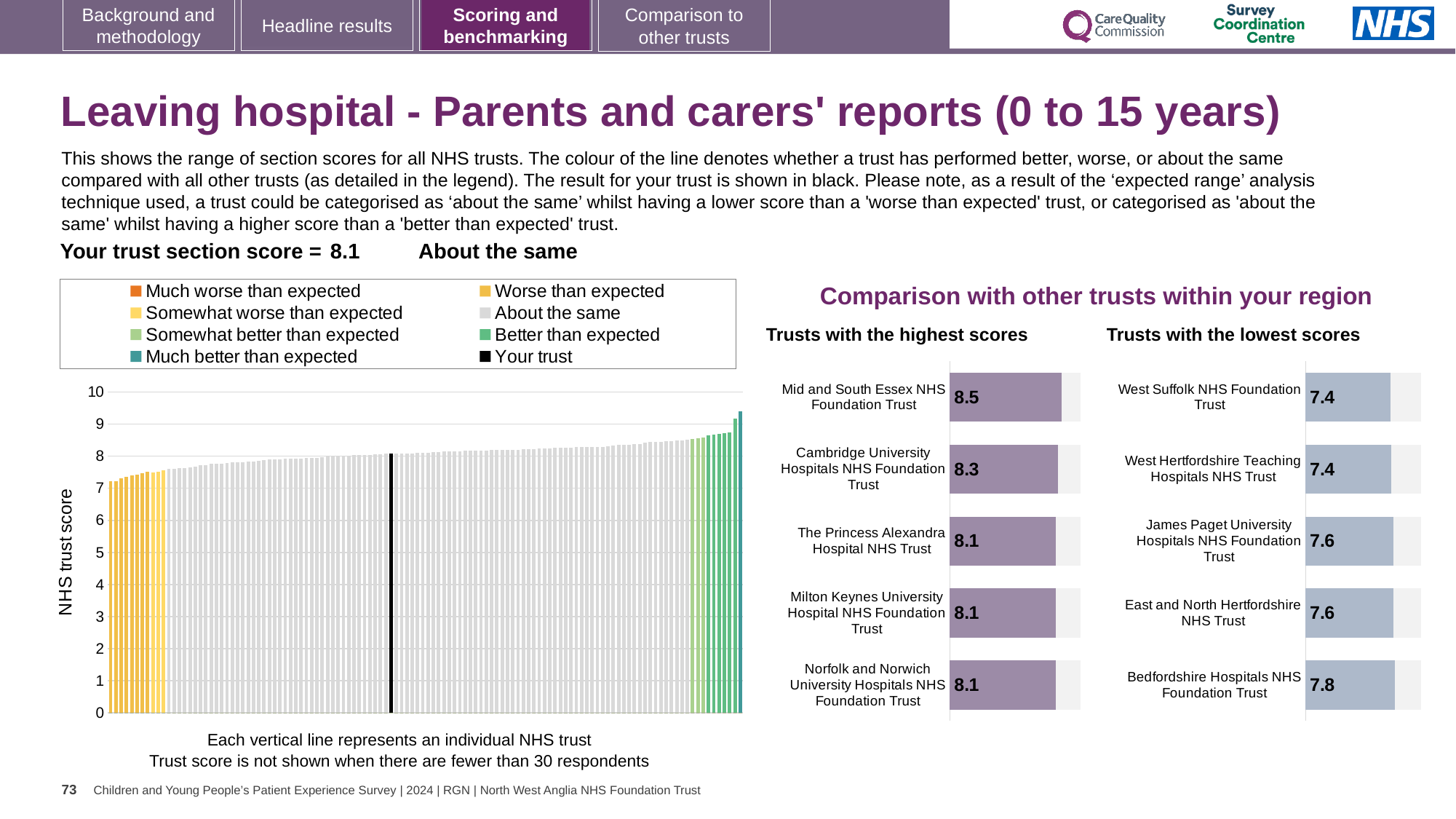
In the large chart on the left, how many entries does the legend list? 8 In the 'Trusts with the highest scores' chart, what is the score for Mid and South Essex NHS Foundation Trust? 8.5 In the 'Trusts with the lowest scores' chart, what is the score for Bedfordshire Hospitals NHS Foundation Trust? 7.8 In the large chart on the left, do the trust scores rise or fall from left to right along the x axis? rise In the 'Trusts with the highest scores' chart, how many trusts are shown? 5 In the 'Trusts with the lowest scores' chart, which trust has the highest score? Bedfordshire Hospitals NHS Foundation Trust In the 'Trusts with the lowest scores' chart, what is the difference between the scores of Bedfordshire Hospitals NHS Foundation Trust and West Suffolk NHS Foundation Trust? 0.4 What kind of chart is the large chart on the left with the y-axis labelled 'NHS trust score'? bar chart In the large chart on the left, what is the section score for your trust (the black bar)? 8.1 In the 'Trusts with the highest scores' chart, which trust has the highest score? Mid and South Essex NHS Foundation Trust In the 'Trusts with the highest scores' chart, what is the difference between the scores of Mid and South Essex NHS Foundation Trust and Cambridge University Hospitals NHS Foundation Trust? 0.2 In the large chart on the left, is the value of the tallest bar greater or less than 9? greater